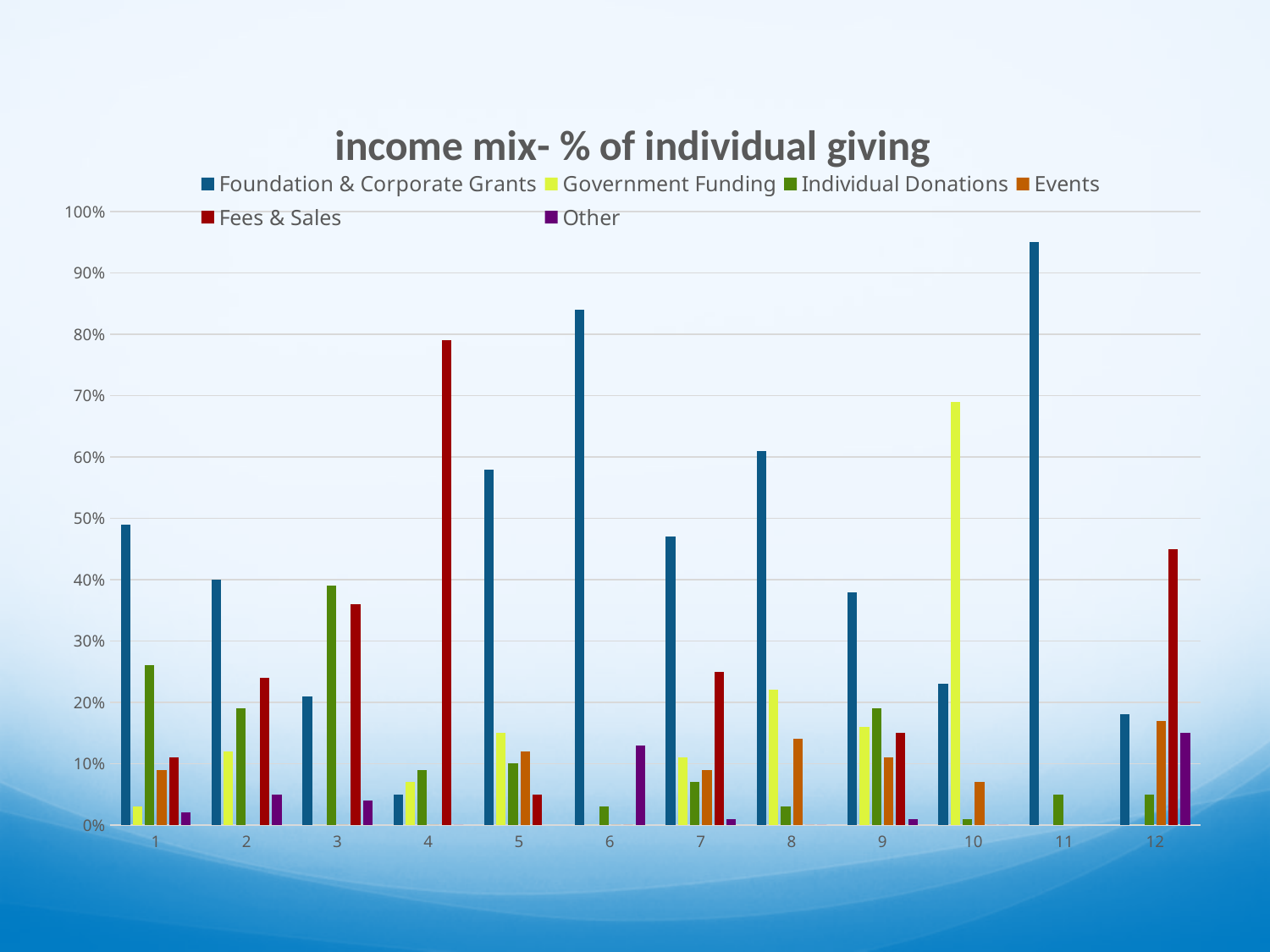
Is the Fees & Sales value for category 4 greater or less than 70%? greater Which category has the highest Foundation & Corporate Grants bar? 11 Is the Government Funding value for category 10 greater or less than 60%? greater In category 3, which is larger: Individual Donations or Foundation & Corporate Grants? Individual Donations How many series does the legend list? 6 What colour represents Fees & Sales in the legend? Dark red Which category has the lowest Foundation & Corporate Grants bar? 4 Is the Foundation & Corporate Grants value for category 11 greater or less than 90%? greater How many categories are shown along the x axis? 12 What is the title of the chart? income mix- % of individual giving Which is larger: the Foundation & Corporate Grants value for category 6 or for category 5? Category 6 What kind of chart is shown on the slide? Bar chart